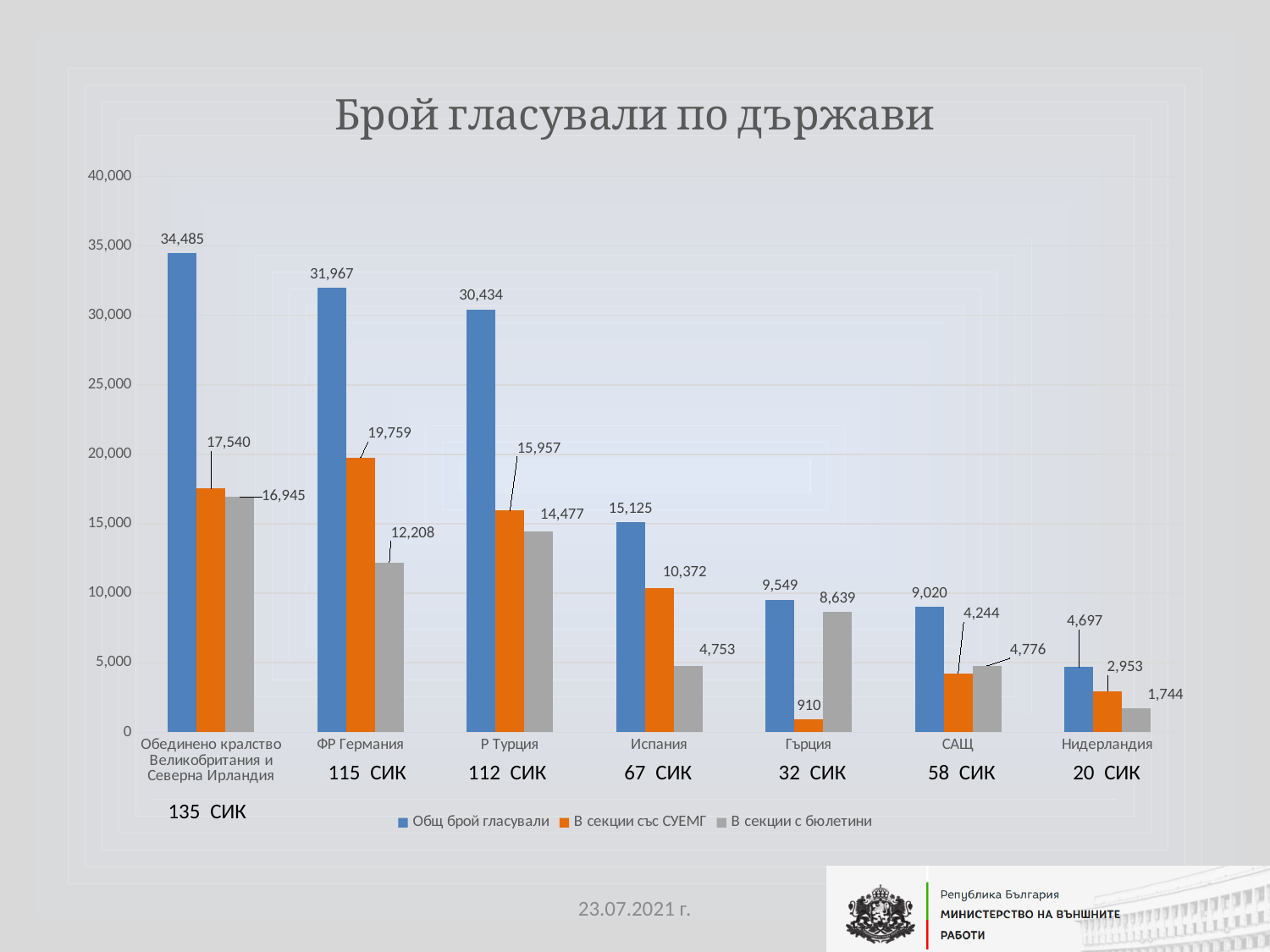
How many series does the legend list? 3 What is the title of the chart? Брой гласували по държави What is the value of 'В секции с бюлетини' for Р Турция? 14,477 Which country has the highest value for 'Общ брой гласували'? Обединено кралство Великобритания и Северна Ирландия For САЩ, which is larger: 'В секции със СУЕМГ' or 'В секции с бюлетини'? В секции с бюлетини What is the value of 'В секции със СУЕМГ' for Гърция? 910 Do the 'Общ брой гласували' values rise or fall from left to right along the x axis? fall What type of chart is shown on the slide? bar chart Which country has the lowest value for 'В секции с бюлетини'? Нидерландия What is the value of 'Общ брой гласували' for ФР Германия? 31,967 What is the difference between 'В секции със СУЕМГ' and 'В секции с бюлетини' for Испания? 5,619 How many countries (categories) are shown on the x axis? 7